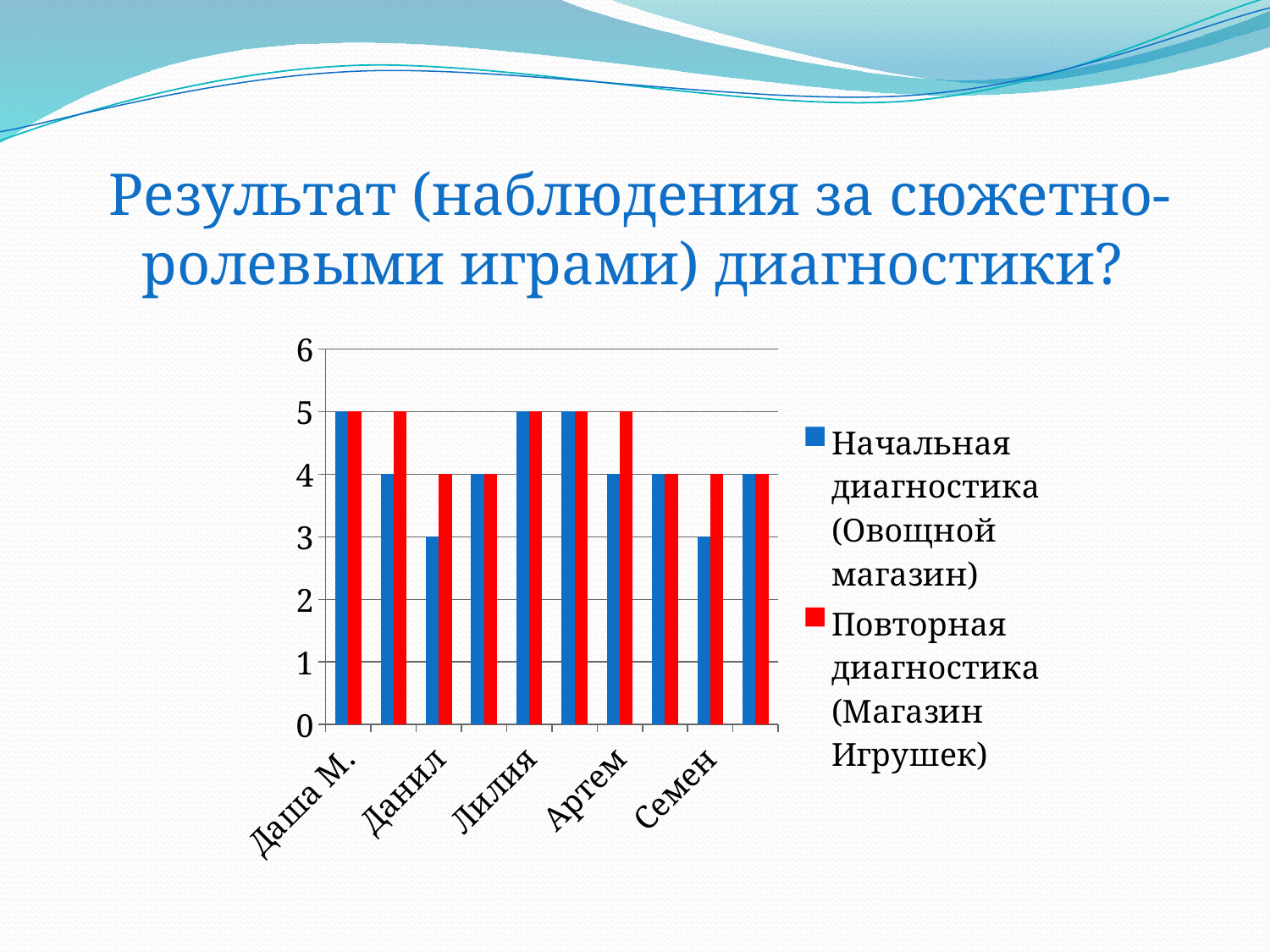
By how much does Повторная диагностика exceed Начальная диагностика for Данил? 1 What is the value of Начальная диагностика (Овощной магазин) for Семен? 3 What is the value of Повторная диагностика (Магазин Игрушек) for Артем? 5 What type of chart is shown on the slide? bar chart Which colour represents Повторная диагностика (Магазин Игрушек) in the legend? red Is the value of Начальная диагностика for Семен greater or less than 4? less What is the value of Начальная диагностика (Овощной магазин) for Данил? 3 What is the value of Повторная диагностика (Магазин Игрушек) for Лилия? 5 How many series does the legend list? 2 What is the value of Начальная диагностика (Овощной магазин) for Даша М.? 5 What is the value of Повторная диагностика (Магазин Игрушек) for Данил? 4 Which is larger for Начальная диагностика: the value for Даша М. or the value for Данил? Даша М.